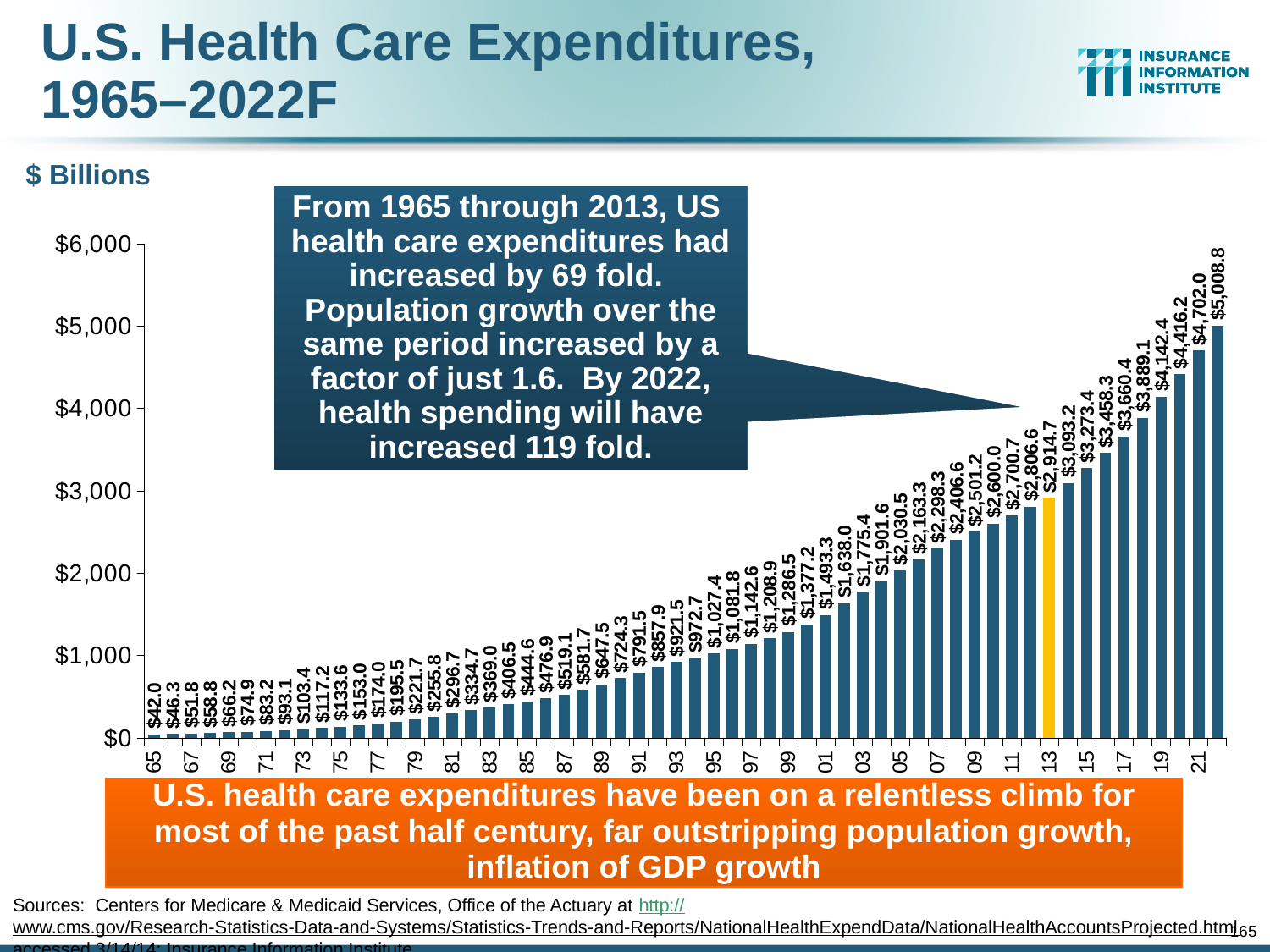
What is the value shown for 2000 (labelled 01 is the next bar)? $1,377.2 Is the value for 2010 greater or less than $2,000? greater What is the value shown for 1965, the first bar on the chart? $42.0 Which year has the lowest health care expenditure on the chart? 1965 Do the values rise or fall from 1965 to 2022F along the x axis? Rise What is the difference between the 2022F value ($5,008.8) and the 2013 value ($2,914.7)? $2,094.1 How many bars (years) are plotted on the chart? 58 What is the value of the highlighted (yellow) bar for 2013? $2,914.7 Which year has the highest health care expenditure on the chart? 2022F What is the value shown for the last bar, 2022F? $5,008.8 Which is larger, the value for 2005 or the value for 1995? 2005 What kind of chart is shown on the slide? Bar chart